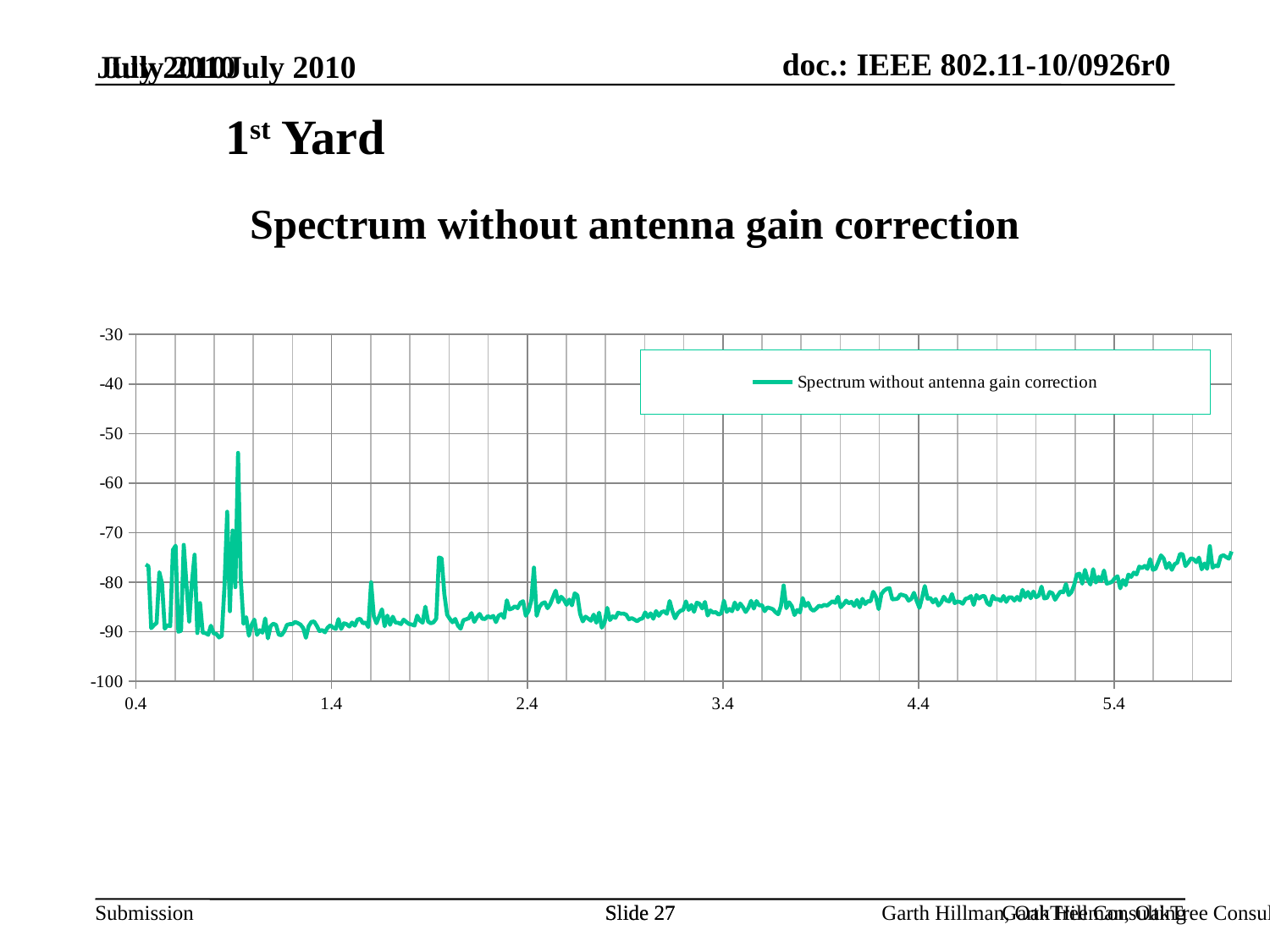
What is the lowest value labeled on the y axis? -100 Is the value of the line at x = 5.4 greater or less than -90? greater Is the highest peak of the line (near x = 0.9) greater or less than -60? greater Is the value of the line at x = 3.4 greater or less than -80? less What is the name of the series shown in the legend? Spectrum without antenna gain correction How many labeled tick marks are on the x axis? 6 What is the title of the chart? Spectrum without antenna gain correction Between x = 3.4 and x = 5.4, does the line generally rise or fall? rise How many series does the legend list? 1 What kind of chart is shown on the slide? line chart